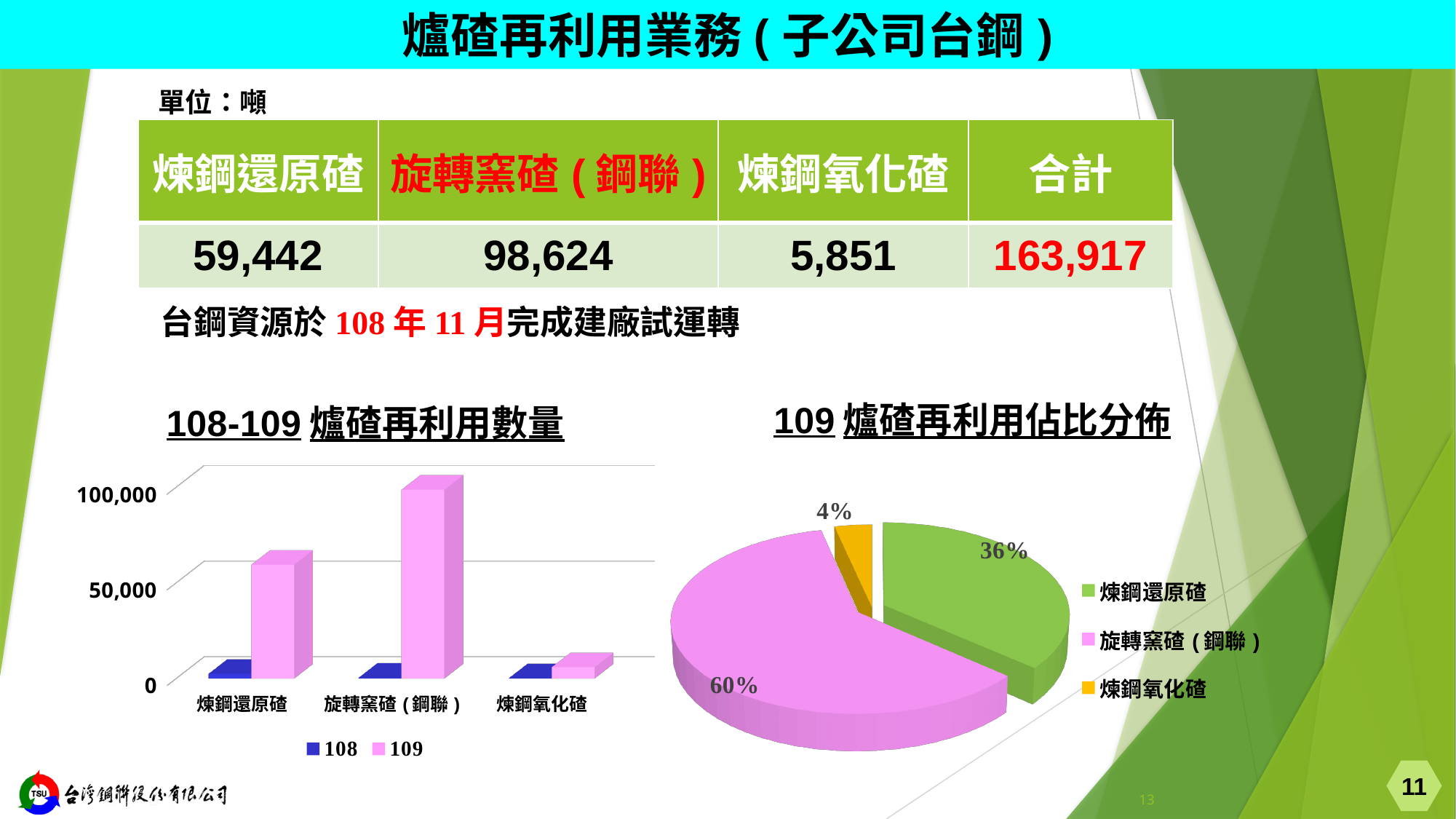
In the "108-109 爐碴再利用數量" chart, which category has the highest 109 bar? 旋轉窯碴(鋼聯) In the "108-109 爐碴再利用數量" chart, how many series does the legend list? 2 In the "109 爐碴再利用佔比分佈" pie chart, which category has the smallest slice? 煉鋼氧化碴 In the "108-109 爐碴再利用數量" chart, for 旋轉窯碴(鋼聯), which series has the larger value, 108 or 109? 109 In the "108-109 爐碴再利用數量" chart, how many categories are shown on the x axis? 3 In the "109 爐碴再利用佔比分佈" pie chart, what share does 旋轉窯碴(鋼聯) have? 60% In the "108-109 爐碴再利用數量" chart, is the 109 value for 煉鋼氧化碴 greater or less than 50,000? less In the "108-109 爐碴再利用數量" chart, is the 109 value for 煉鋼還原碴 greater or less than 50,000? greater What kind of chart is the "108-109 爐碴再利用數量" chart on the left? bar chart In the "108-109 爐碴再利用數量" chart, what colour are the 109 bars? pink What kind of chart is the "109 爐碴再利用佔比分佈" chart on the right? pie chart In the "109 爐碴再利用佔比分佈" pie chart, how many percentage points larger is the 旋轉窯碴(鋼聯) slice than the 煉鋼還原碴 slice? 24%